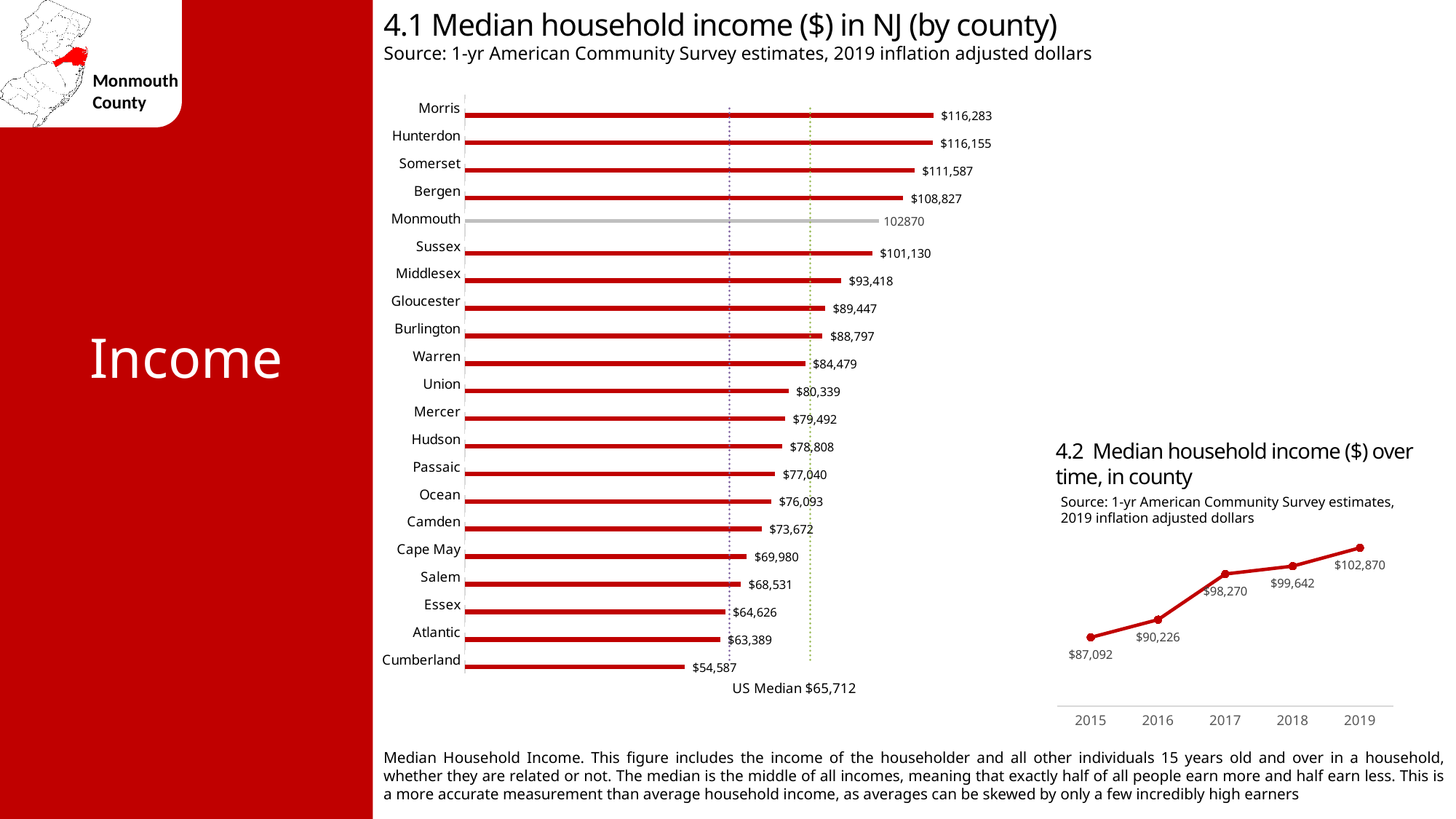
In chart 4.1, what US Median value is noted below the bars? $65,712 In chart 4.1, which county has the lowest median household income? Cumberland In chart 4.1, what is the difference between the median household income of Morris and Hunterdon? $128 What kind of chart is chart 4.1? Bar chart In chart 4.1, which county has a higher median household income, Gloucester or Burlington? Gloucester In chart 4.1, which county has the highest median household income? Morris In chart 4.2, does the median household income rise or fall from 2015 to 2019? Rise In chart 4.2, what is the difference between the 2019 and 2015 values? $15,778 In chart 4.1 (Median household income in NJ by county), what is the median household income for Somerset? $111,587 In chart 4.1, how many counties are plotted? 21 In chart 4.1, what value is shown for Monmouth? 102870 In chart 4.2 (Median household income over time, in county), what is the value for 2016? $90,226